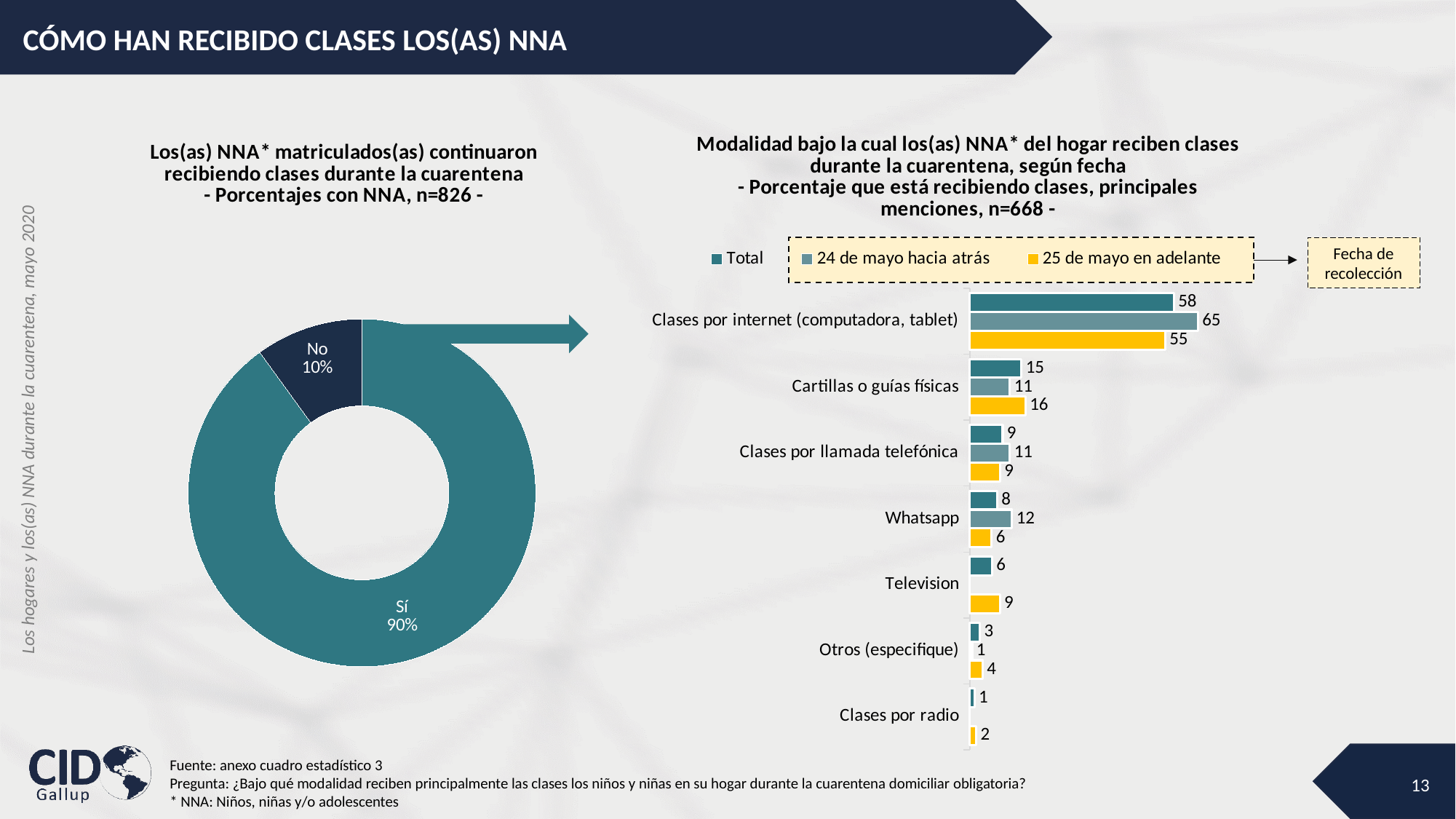
How many categories are shown in the bar chart on the right? 7 What type of chart is the chart on the left of the slide? Donut (pie) chart In the bar chart on the right, which category has the highest Total value? Clases por internet (computadora, tablet) In the bar chart on the right, which is larger for 'Cartillas o guías físicas': the '24 de mayo hacia atrás' value or the '25 de mayo en adelante' value? 25 de mayo en adelante How many series does the legend of the bar chart on the right list? 3 In the donut chart on the left, what share of the pie does the 'No' slice represent? 10% In the bar chart on the right, what is the value for 'Television' in the '25 de mayo en adelante' series? 9 In the donut chart on the left, what percentage of enrolled NNA continued receiving classes during the quarantine (Sí)? 90% In the bar chart on the right, which category has the lowest Total value? Clases por radio In the bar chart on the right, what is the value for 'Whatsapp' in the '24 de mayo hacia atrás' series? 12 In the bar chart on the right, what is the Total value for 'Clases por internet (computadora, tablet)'? 58 In the bar chart on the right, what is the difference between the '24 de mayo hacia atrás' and '25 de mayo en adelante' values for 'Clases por internet (computadora, tablet)'? 10